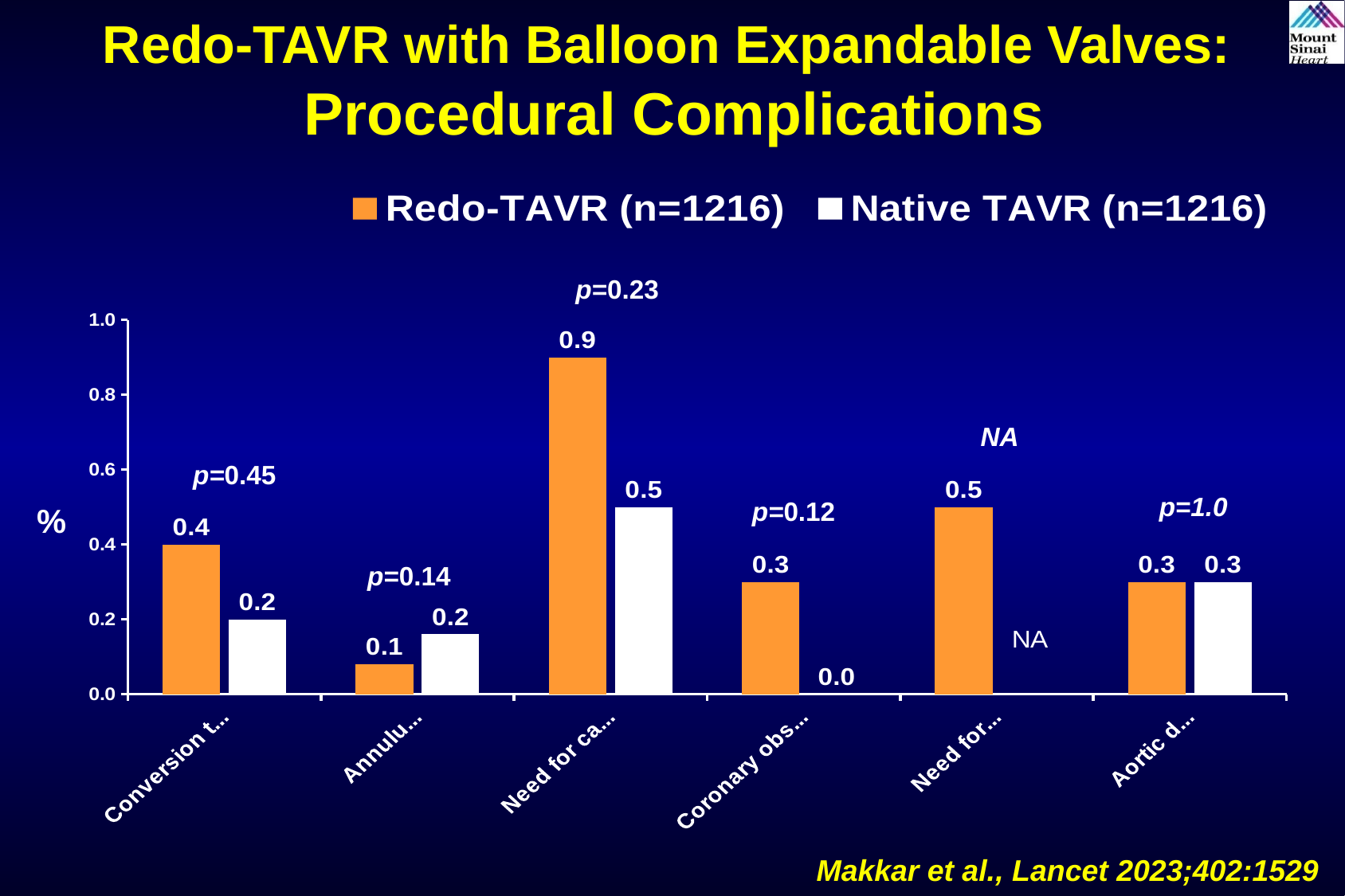
What is the Redo-TAVR (n=1216) value for the third category (Need for ca...)? 0.9 What is shown for the Native TAVR (n=1216) value in the fifth category (Need for...)? NA How many categories are plotted along the x axis? 6 What is the Native TAVR (n=1216) value for the first category (Conversion t...)? 0.2 Which category has the lowest Redo-TAVR (n=1216) value? Annulu... (second category) In the third category (Need for ca...), what is the difference between the Redo-TAVR and Native TAVR values? 0.4 How many series does the legend list? 2 In the first category (Conversion t...), which series has the larger value, Redo-TAVR or Native TAVR? Redo-TAVR What kind of chart is shown on the slide? bar chart What is the Native TAVR (n=1216) value for the fourth category (Coronary obs...)? 0.0 What p-value is printed above the third category (Need for ca...)? p=0.23 Which category has the highest Redo-TAVR (n=1216) value? Need for ca... (third category)